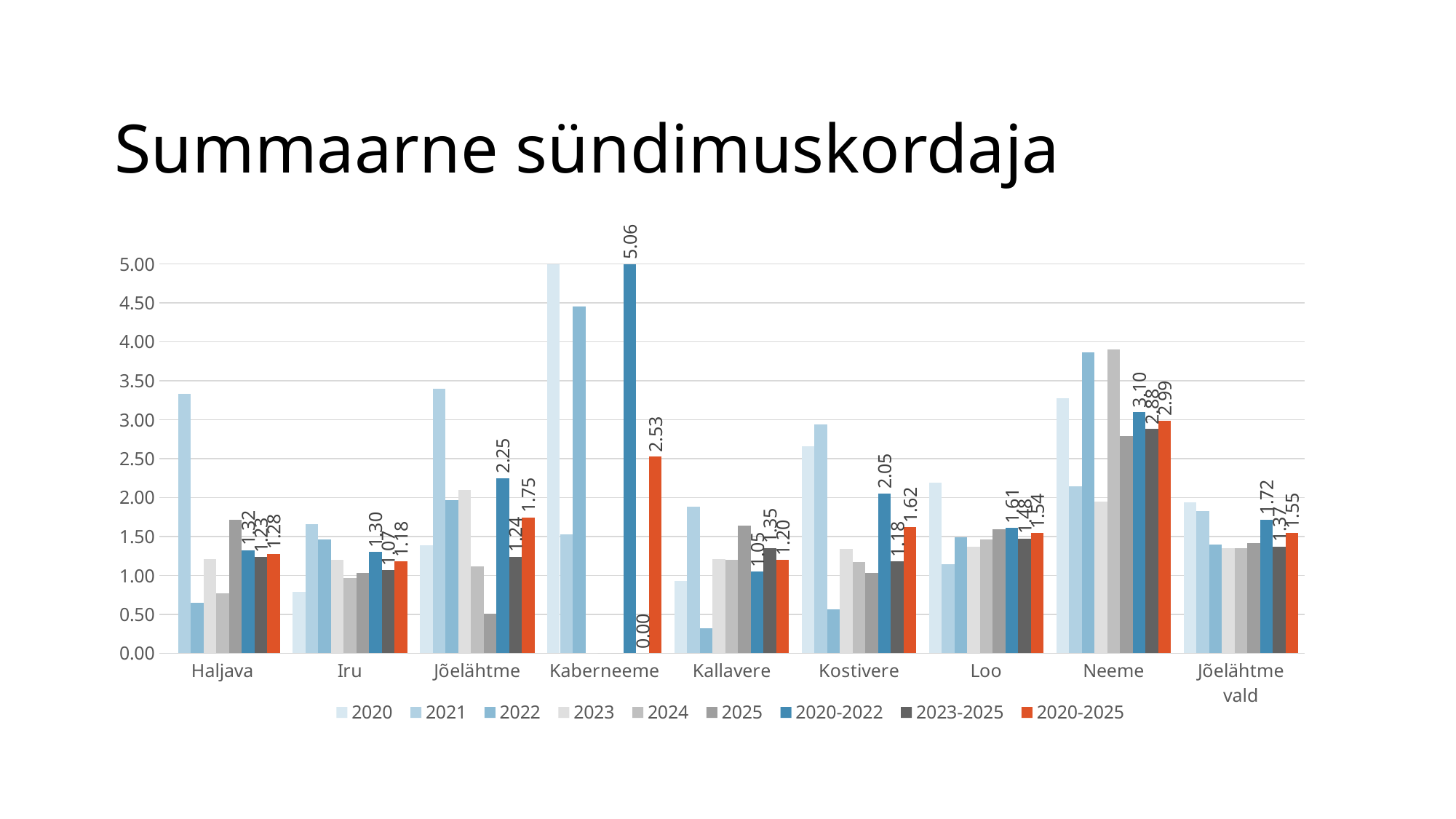
What is the value of the 2023-2025 series for Kaberneeme? 0.00 Which is larger: the 2020-2025 value for Jõelähtme or the 2020-2025 value for Kostivere? Jõelähtme How many categories are shown on the x axis? 9 What is the title of the slide? Summaarne sündimuskordaja How many series does the legend list? 9 Which category has the lowest value in the 2020-2022 series? Kallavere What is the value of the 2020-2025 series for Neeme? 2.99 Is the 2021 value for Haljava greater or less than 3.00? greater What is the value of the 2020-2022 series for Kaberneeme? 5.06 What kind of chart is shown on the slide? bar chart Which category has the highest value in the 2020-2025 series? Neeme What is the difference between the 2020-2022 value and the 2023-2025 value for Neeme? 0.22